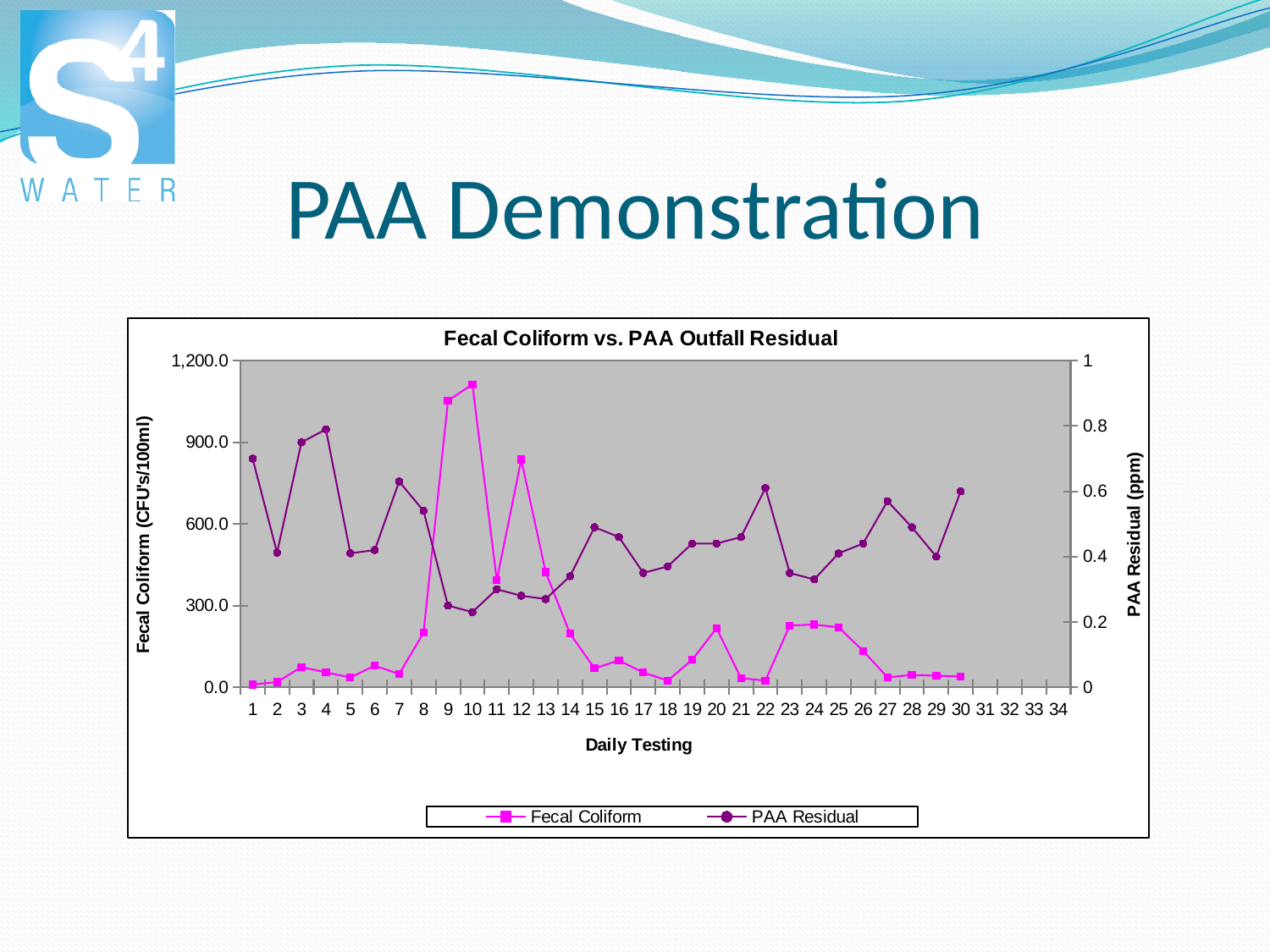
Is the Fecal Coliform value on day 10 greater or less than 900.0? greater What is the label of the x axis? Daily Testing Which is larger, the Fecal Coliform value on day 9 or on day 12? Day 9 How many day labels are shown on the x axis? 34 Is the PAA Residual value on day 1 greater or less than 0.6? greater What kind of chart is shown on the slide? Line chart Does the Fecal Coliform value rise or fall from day 10 to day 11? Fall What is the title of the chart? Fecal Coliform vs. PAA Outfall Residual On which day does Fecal Coliform reach its highest value? 10 Is the Fecal Coliform value on day 1 greater or less than 300.0? less How many series does the legend list? 2 On which day is the PAA Residual at its lowest? 10